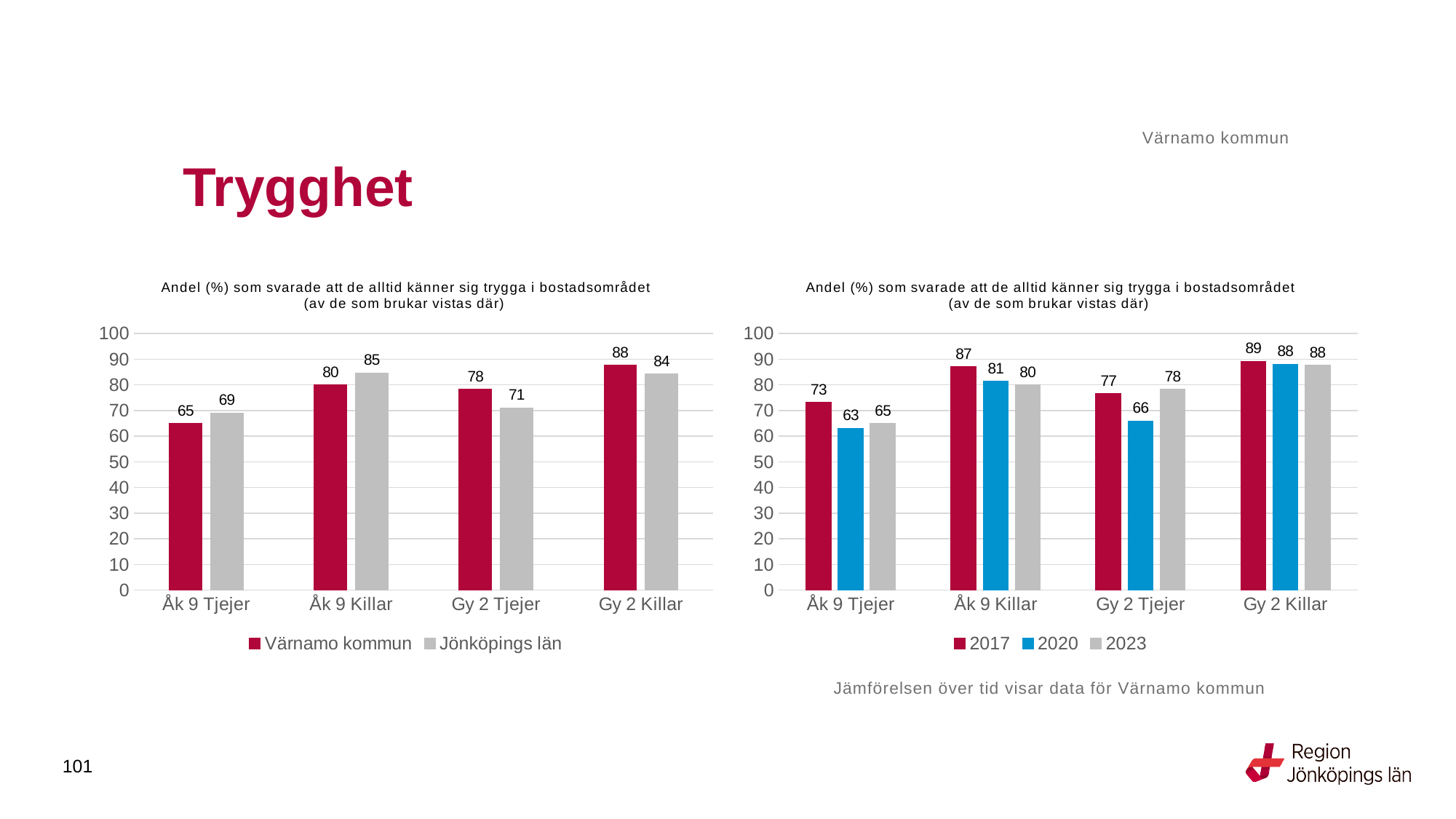
How many series does the legend of the left chart list? 2 In the right chart, what is the difference between 2017 and 2020 for Gy 2 Tjejer? 11 In the right chart, which category has the lowest value for 2023? Åk 9 Tjejer In the right chart, what is the value for 2020 for Åk 9 Tjejer? 63 In the left chart, what is the value for Jönköpings län for Gy 2 Tjejer? 71 How many series does the legend of the right chart list? 3 In the left chart, which is larger for Gy 2 Tjejer: Värnamo kommun or Jönköpings län? Värnamo kommun In the right chart, what is the value for 2017 for Gy 2 Killar? 89 In the left chart, which category has the highest value for Värnamo kommun? Gy 2 Killar What kind of chart is the right chart? Bar chart In the left chart, what is the difference between Jönköpings län and Värnamo kommun for Åk 9 Killar? 5 In the left chart, what is the value for Värnamo kommun for Åk 9 Tjejer? 65